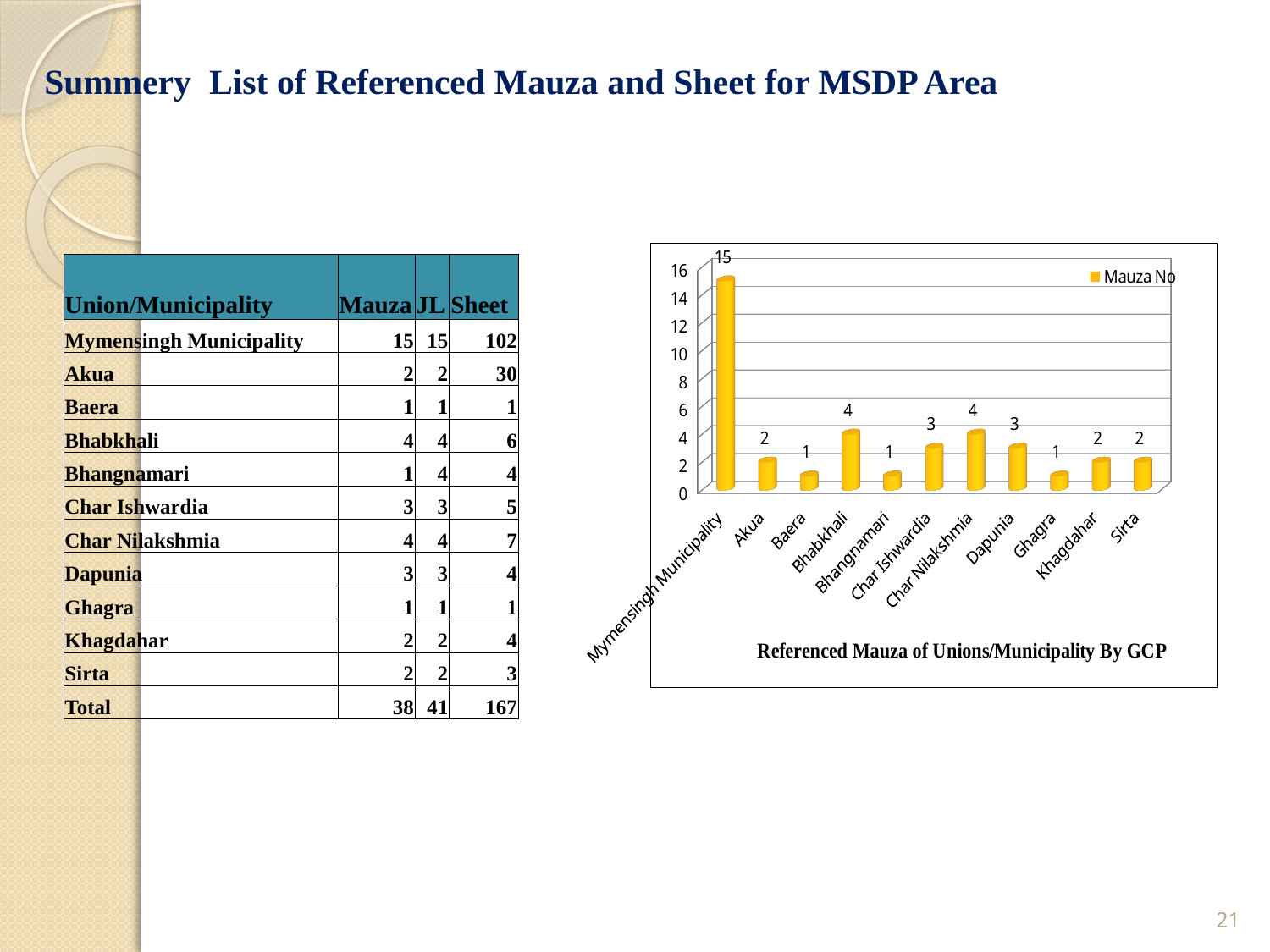
Is the value for Mymensingh Municipality greater or less than 10? greater What is the title of the chart? Referenced Mauza of Unions/Municipality By GCP What kind of chart is shown on the slide? bar chart What is the Mauza No value for Bhabkhali in the chart? 4 Which has a larger Mauza No, Char Nilakshmia or Dapunia? Char Nilakshmia How many series does the chart legend list? 1 What is the Mauza No value for Mymensingh Municipality in the chart? 15 What series name is shown in the chart legend? Mauza No What is the difference between the Mauza No values for Mymensingh Municipality and Akua? 13 Which category has the highest Mauza No in the chart? Mymensingh Municipality What is the Mauza No value for Char Ishwardia in the chart? 3 How many categories are shown on the x axis of the chart? 11